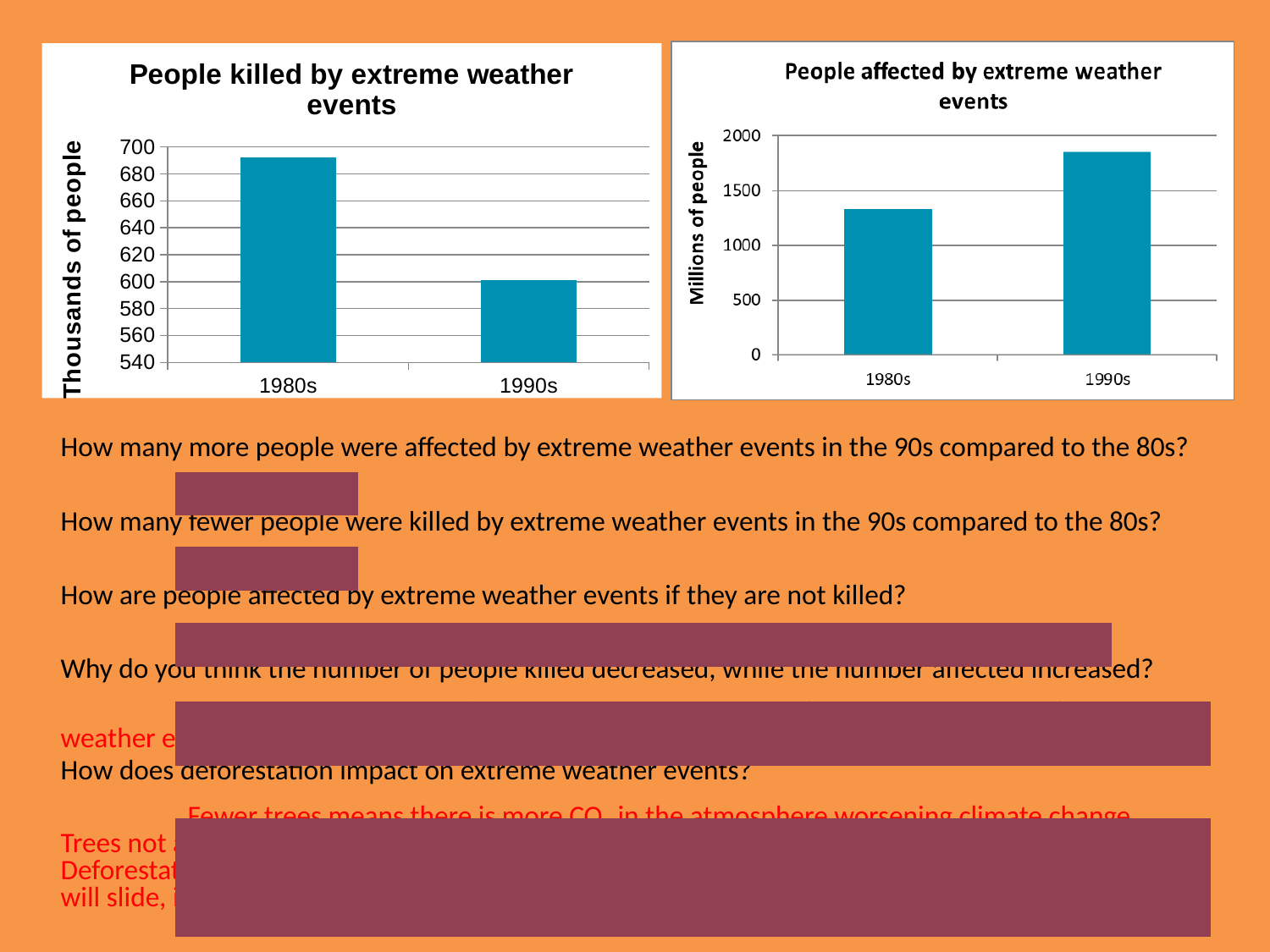
How many categories are shown on the x axis of the 'People affected by extreme weather events' chart? 2 In the 'People killed by extreme weather events' chart, is the value for the 1980s greater or less than 680? greater In the 'People affected by extreme weather events' chart, is the value for the 1990s greater or less than 1500? greater In the 'People affected by extreme weather events' chart, is the value for the 1980s greater or less than 1500? less What is the y-axis label of the 'People affected by extreme weather events' chart? Millions of people In the 'People killed by extreme weather events' chart, which decade has the higher value? 1980s In the 'People killed by extreme weather events' chart, do the values rise or fall from the 1980s to the 1990s? fall In the 'People killed by extreme weather events' chart, which decade has the lower value? 1990s What kind of chart is the 'People killed by extreme weather events' chart? bar chart In the 'People affected by extreme weather events' chart, which decade has the higher value? 1990s In the 'People affected by extreme weather events' chart, do the values rise or fall from the 1980s to the 1990s? rise